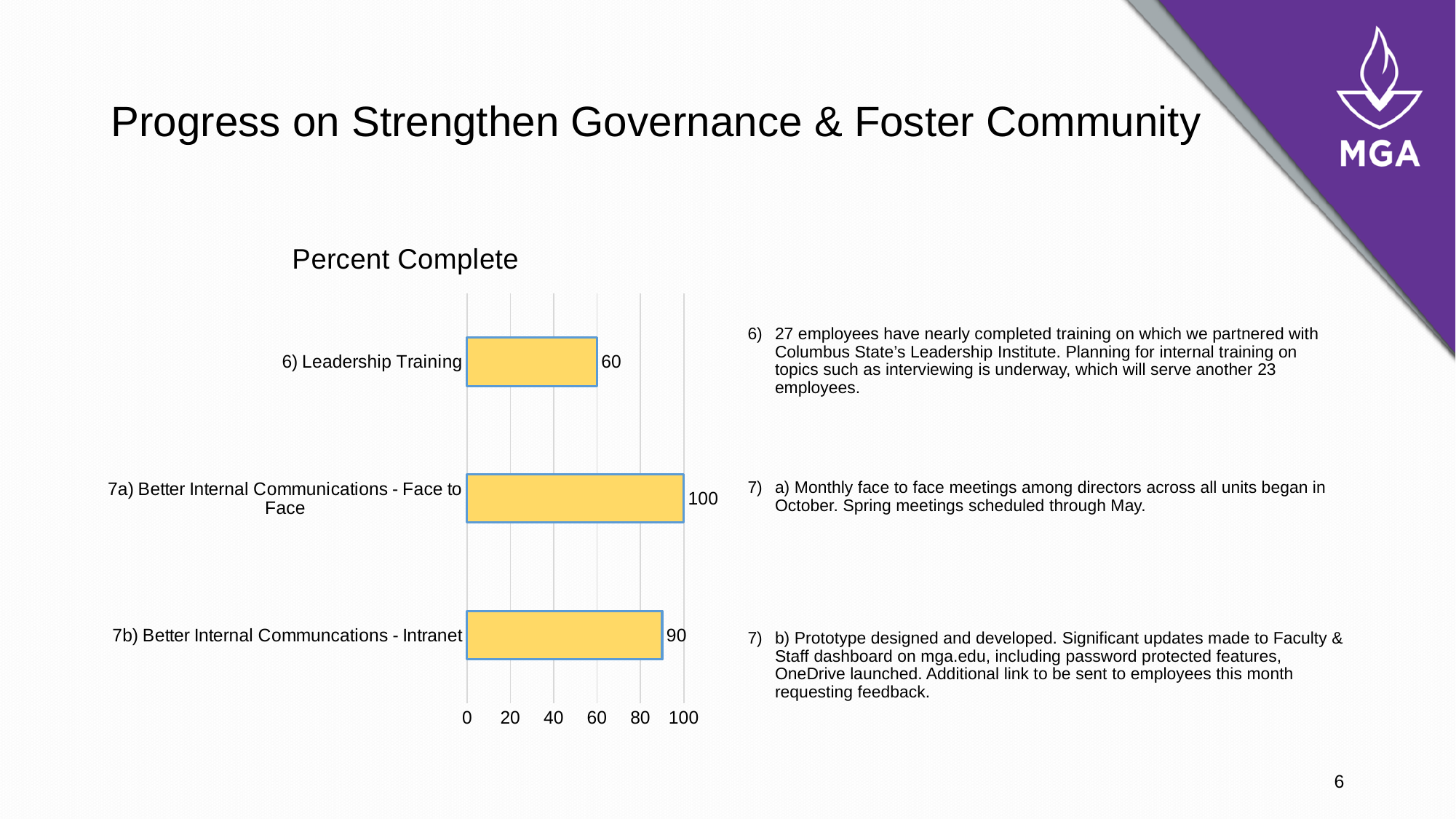
Which category has the highest percent complete? 7a) Better Internal Communications - Face to Face What is the difference between the values for 7b) Better Internal Communcations - Intranet and 6) Leadership Training? 30 How many categories are shown in the chart? 3 Which is larger, the value for 7b) Better Internal Communcations - Intranet or 6) Leadership Training? 7b) Better Internal Communcations - Intranet Is the value for 6) Leadership Training greater or less than 80? less What is the value for 6) Leadership Training? 60 What kind of chart is shown on the slide? bar chart Which category has the lowest percent complete? 6) Leadership Training What is the value for 7b) Better Internal Communcations - Intranet? 90 What is the value for 7a) Better Internal Communications - Face to Face? 100 What is the title of the chart? Percent Complete What is the difference between the values for 7a) Better Internal Communications - Face to Face and 6) Leadership Training? 40